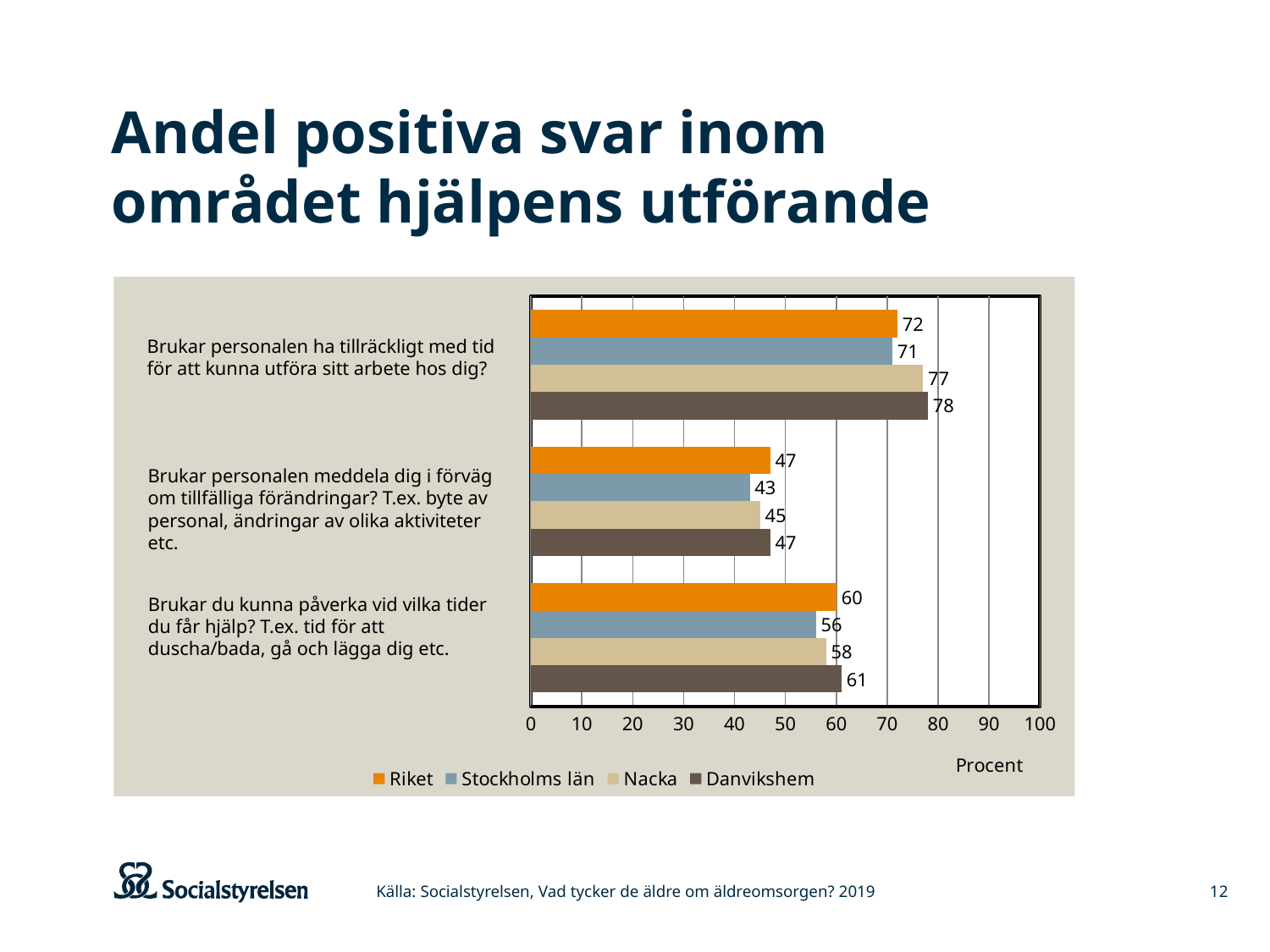
What unit label is shown below the x axis of the chart? Procent Which is larger for Nacka: the value on "Brukar personalen ha tillräckligt med tid..." or the value on "Brukar du kunna påverka vid vilka tider du får hjälp?"? Brukar personalen ha tillräckligt med tid... What kind of chart is shown on the slide? bar chart What is the value for Danvikshem on the question "Brukar personalen ha tillräckligt med tid för att kunna utföra sitt arbete hos dig?"? 78 What is the value for Riket on the question "Brukar du kunna påverka vid vilka tider du får hjälp?"? 60 Which series has the highest value on the question "Brukar du kunna påverka vid vilka tider du får hjälp?"? Danvikshem Is the value for Danvikshem on "Brukar personalen meddela dig i förväg om tillfälliga förändringar?" greater or less than 50? less What is the value for Stockholms län on the question "Brukar personalen meddela dig i förväg om tillfälliga förändringar?"? 43 How many series does the legend list? 4 What is the difference between Nacka and Riket on the question "Brukar personalen ha tillräckligt med tid för att kunna utföra sitt arbete hos dig?"? 5 How many questions (categories) are shown in the chart? 3 Which series has the lowest value on the question "Brukar personalen meddela dig i förväg om tillfälliga förändringar?"? Stockholms län